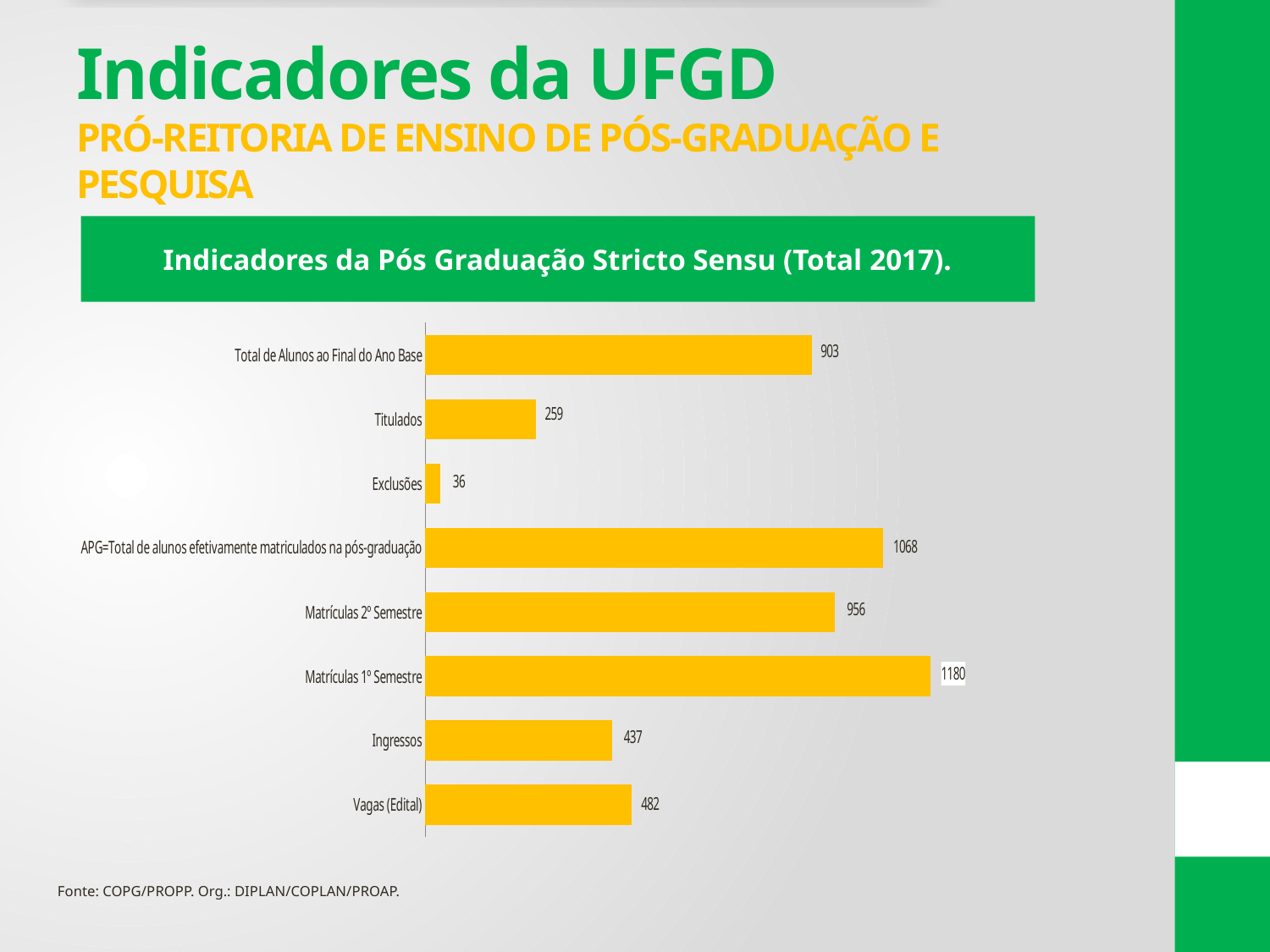
Which is larger, Total de Alunos ao Final do Ano Base or APG=Total de alunos efetivamente matriculados na pós-graduação? APG=Total de alunos efetivamente matriculados na pós-graduação Which category has the lowest value? Exclusões What is the difference between Vagas (Edital) and Ingressos? 45 How many categories are shown in the chart? 8 What is the value for Exclusões? 36 What is the value for Titulados? 259 Which category has the highest value? Matrículas 1º Semestre What is the value for Matrículas 1º Semestre? 1180 What kind of chart is shown on the slide? Bar chart What is the value for Vagas (Edital)? 482 What is the difference between Matrículas 1º Semestre and Matrículas 2º Semestre? 224 What is the title of the chart? Indicadores da Pós Graduação Stricto Sensu (Total 2017).